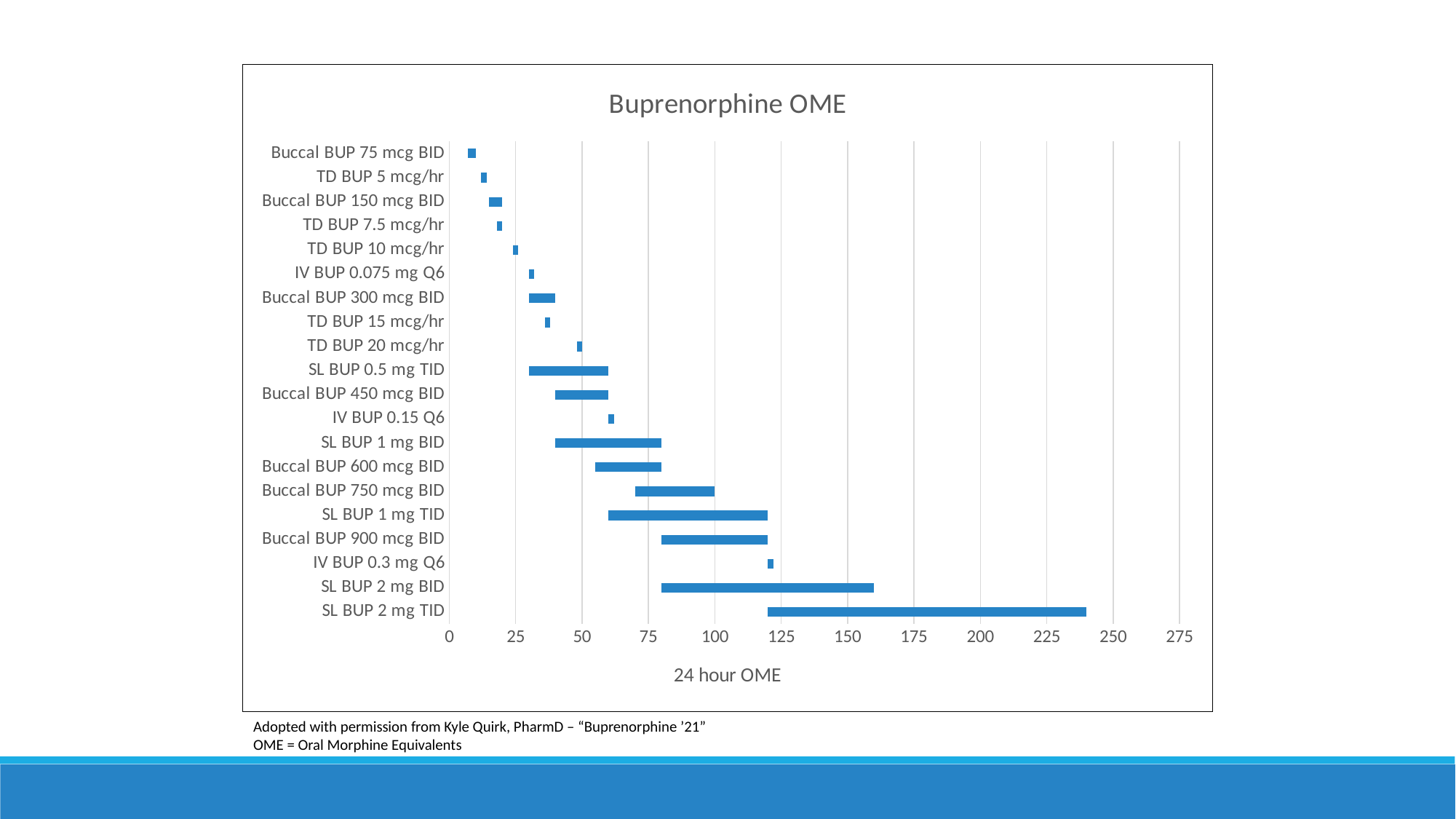
Which category's bar sits closest to 0 on the 24 hour OME axis? Buccal BUP 75 mcg BID Do the bars generally move toward higher 24 hour OME values going from the top category to the bottom category? Yes, they increase What is the label of the horizontal axis? 24 hour OME What is the title of the chart? Buprenorphine OME Is the upper end of the bar for Buccal BUP 750 mcg BID greater or less than 125? less Is the upper end of the bar for SL BUP 2 mg BID greater or less than 150? greater Is the value for Buccal BUP 75 mcg BID greater or less than 25? less What type of chart is shown on the slide? Bar chart Which bar reaches a higher 24 hour OME value, SL BUP 2 mg TID or SL BUP 2 mg BID? SL BUP 2 mg TID How many categories (dosing regimens) are listed on the chart? 20 Which category's bar extends to the highest 24 hour OME value? SL BUP 2 mg TID